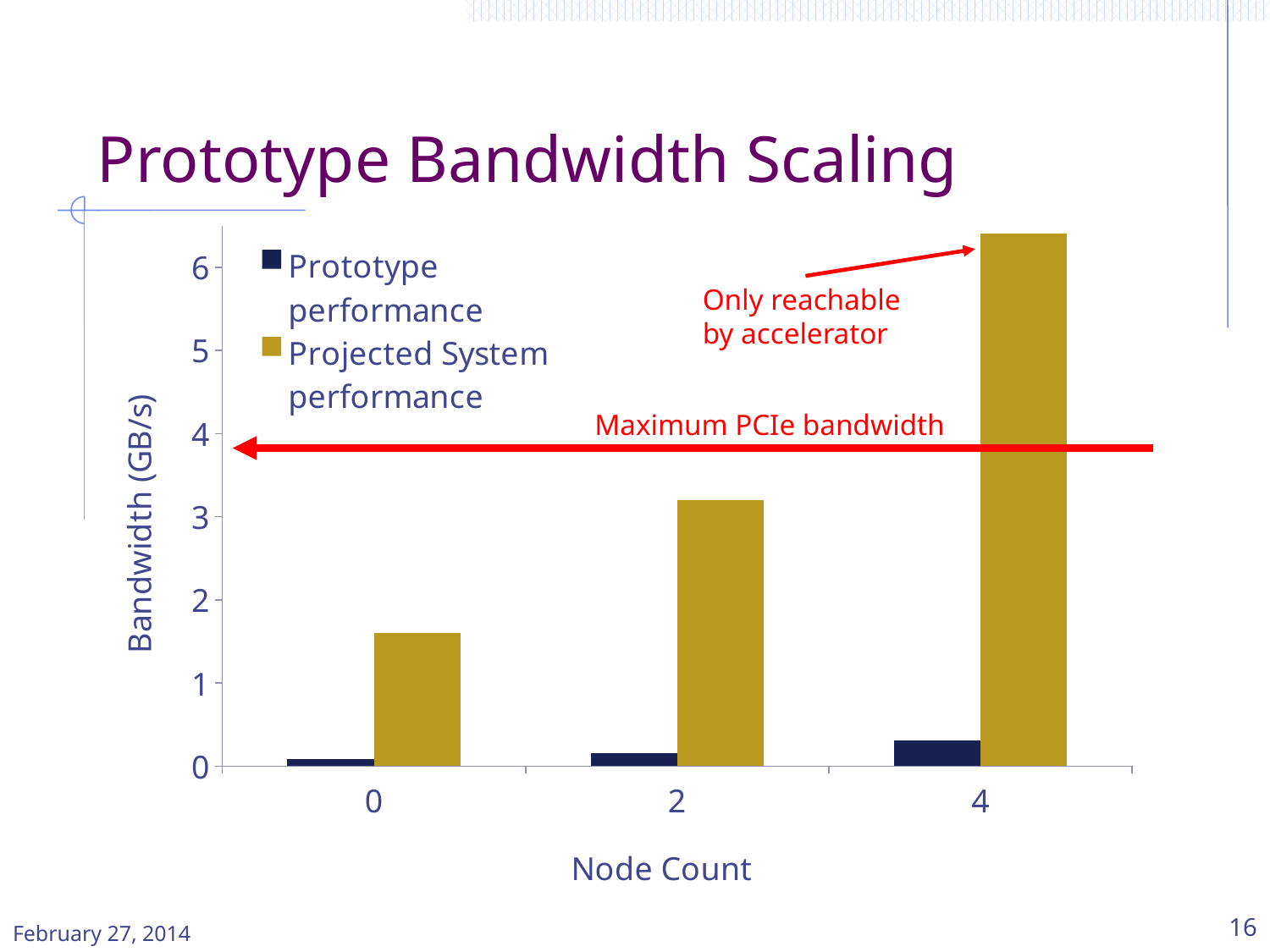
What is the label of the y axis? Bandwidth (GB/s) How many series does the legend list? 2 Is the Prototype performance at node count 4 greater or less than 1? less At node count 2, which is larger: Prototype performance or Projected System performance? Projected System performance Which node count has the lowest Projected System performance? 0 How many node count categories are shown on the x axis? 3 Is the Projected System performance at node count 2 greater or less than 4? less Is the Projected System performance at node count 0 greater or less than 2? less What kind of chart is shown on the slide? bar chart Which node count has the highest Projected System performance? 4 Do the Projected System performance values rise or fall as node count increases? rise